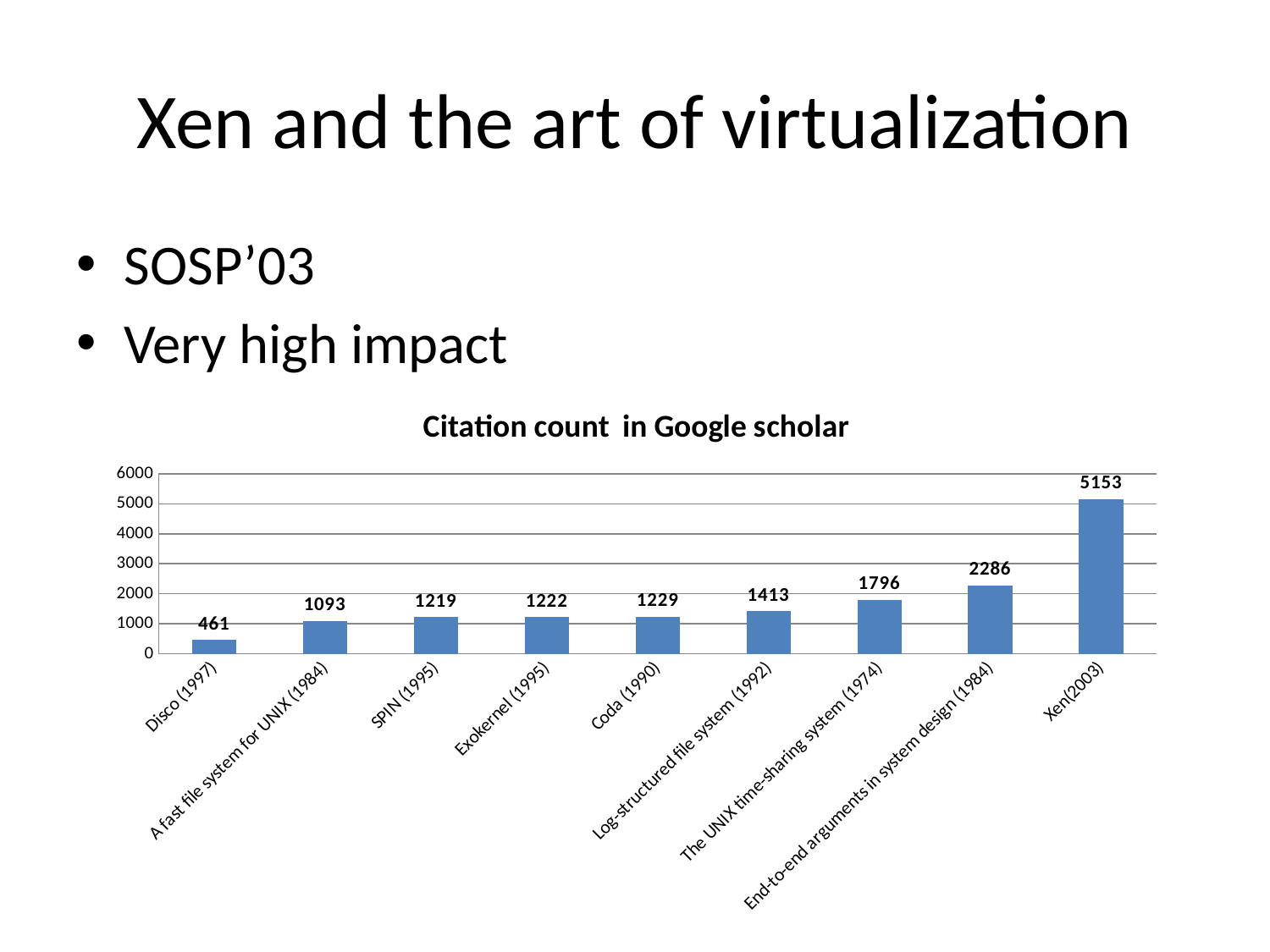
What is the citation count for End-to-end arguments in system design (1984)? 2286 What is the citation count for The UNIX time-sharing system (1974)? 1796 What is the citation count for Disco (1997)? 461 What is the title of the chart? Citation count in Google scholar What is the difference in citation count between Xen(2003) and End-to-end arguments in system design (1984)? 2867 What is the citation count for Xen(2003)? 5153 How many papers are shown in the chart? 9 Which paper has the highest citation count? Xen(2003) What kind of chart is shown on the slide? bar chart Which paper has the lowest citation count? Disco (1997) Which has more citations, Log-structured file system (1992) or Coda (1990)? Log-structured file system (1992) Is the citation count for A fast file system for UNIX (1984) greater or less than 1000? greater